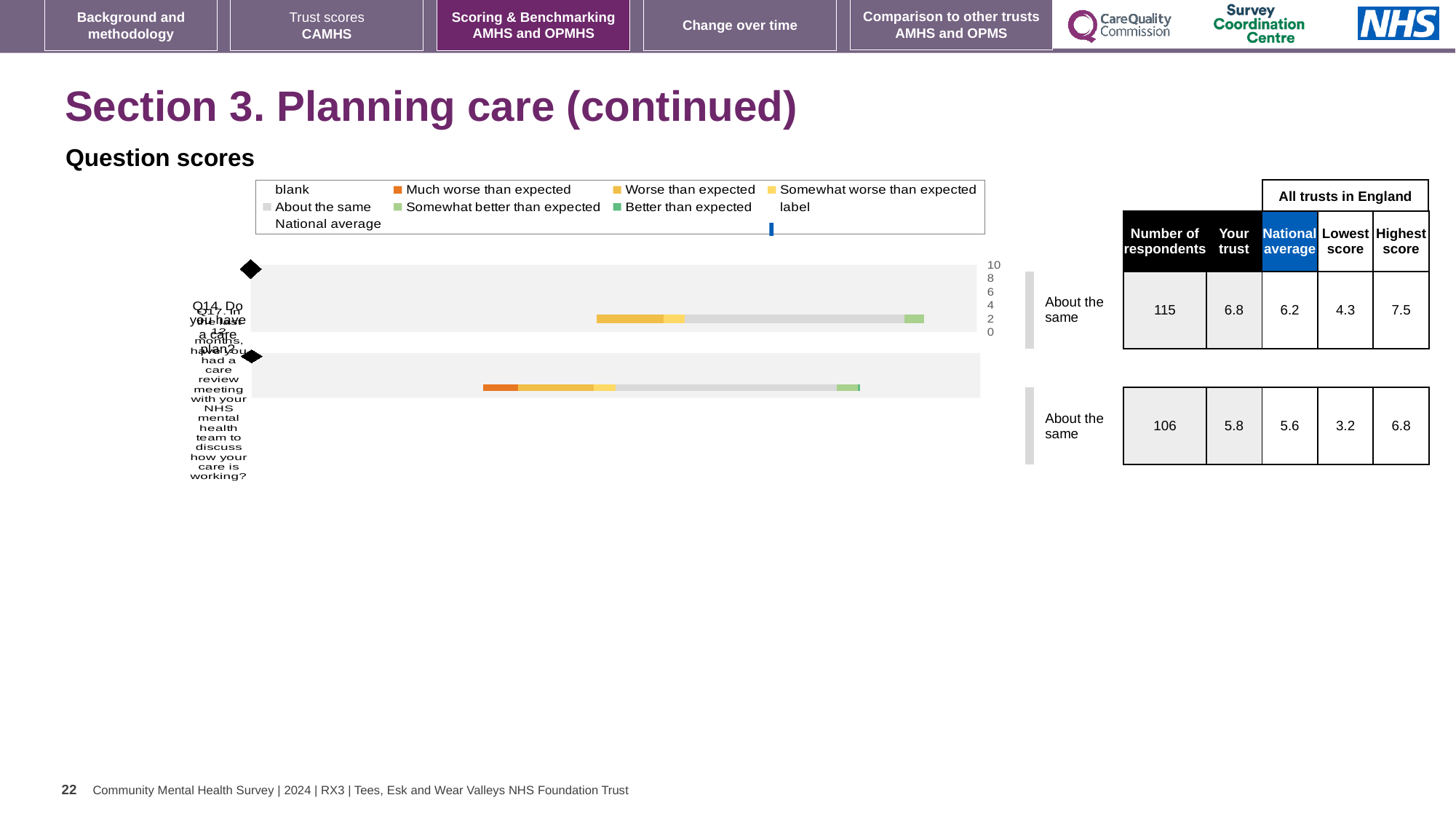
What kind of chart is shown under 'Question scores'? bar chart How many entries does the chart legend list? 9 What colour does the legend use for 'Much worse than expected'? orange In the table beside the chart, what is the national average for Q17 (care review meeting)? 5.6 What benchmark category is shown next to the Q14 bar? About the same How many questions (bars) are plotted in the chart? 2 What is the highest tick value shown on the chart's axis? 10 In the table beside the chart, what is the 'Your trust' score for Q14 (Do you have a care plan?)? 6.8 In the table beside the chart, which question has the higher 'Your trust' score, Q14 or Q17? Q14 In the table beside the chart, what is the difference between the highest score and the lowest score for Q14? 3.2 In the table beside the chart, how many respondents answered Q17? 106 What benchmark category is shown next to the Q17 bar? About the same